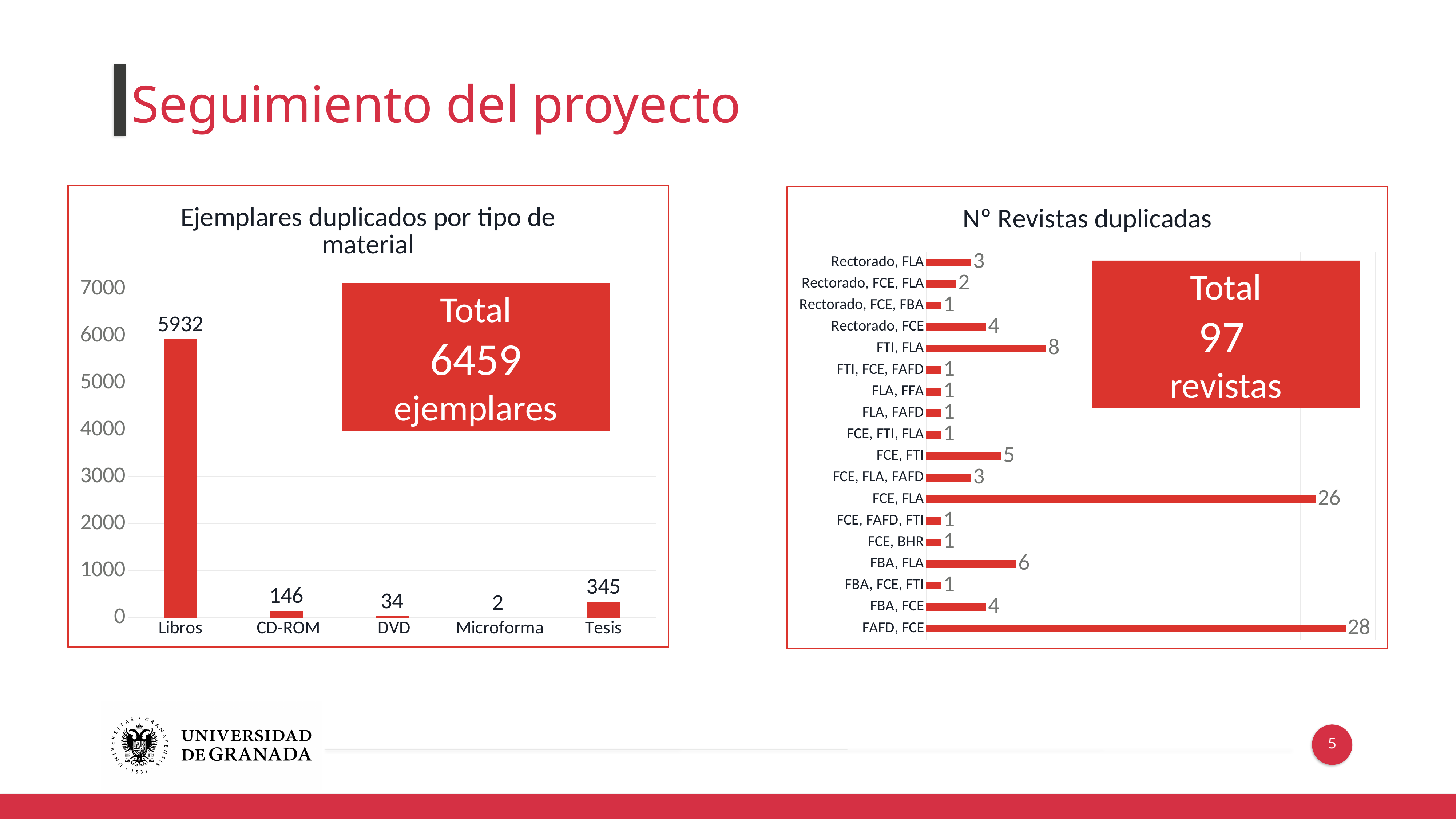
In the chart 'Ejemplares duplicados por tipo de material', what is the difference between the values for CD-ROM and DVD? 112 In the chart 'Ejemplares duplicados por tipo de material', what total is shown in the red box? 6459 ejemplares In the chart 'Ejemplares duplicados por tipo de material', how many categories are shown on the x axis? 5 In the chart 'Nº Revistas duplicadas', which category has the highest value? FAFD, FCE In the chart 'Nº Revistas duplicadas', how many categories are listed? 18 In the chart 'Nº Revistas duplicadas', what is the difference between the values for FAFD, FCE and FCE, FLA? 2 In the chart 'Nº Revistas duplicadas', which is larger, FTI, FLA or FBA, FLA? FTI, FLA In the chart 'Ejemplares duplicados por tipo de material', which category has the lowest value? Microforma In the chart 'Ejemplares duplicados por tipo de material', what is the value for Libros? 5932 In the chart 'Nº Revistas duplicadas', what is the value for FCE, FLA? 26 In the chart 'Ejemplares duplicados por tipo de material', what is the value for Tesis? 345 What kind of chart is 'Nº Revistas duplicadas'? Bar chart